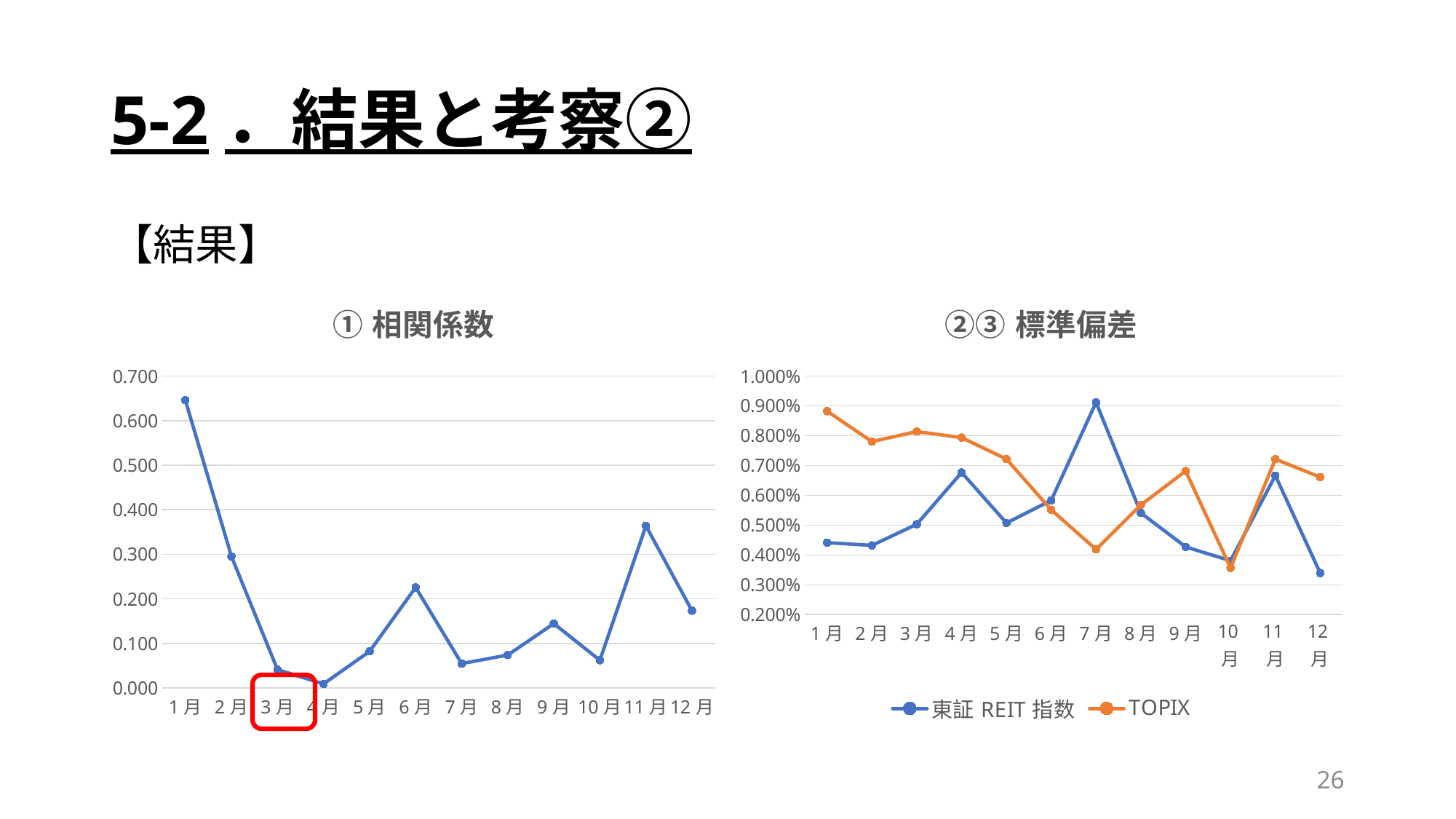
In the ②③ 標準偏差 chart, which month has the lowest value for TOPIX? 10月 In the ① 相関係数 chart, is the value for 11月 greater or less than 0.300? greater In the ① 相関係数 chart, which month has the highest value? 1月 How many series does the legend of the ②③ 標準偏差 chart list? 2 In the ②③ 標準偏差 chart, do the TOPIX values rise or fall from 1月 to 5月? fall In the ① 相関係数 chart, do the values rise or fall from 1月 to 3月? fall In the ① 相関係数 chart, is the value for 1月 greater or less than 0.600? greater In the ① 相関係数 chart, is the value for 7月 greater or less than 0.100? less In the ②③ 標準偏差 chart, which series has the larger value in 1月, 東証 REIT 指数 or TOPIX? TOPIX In the ②③ 標準偏差 chart, which month has the highest value for 東証 REIT 指数? 7月 How many months are plotted on the x axis of the ① 相関係数 chart? 12 What kind of chart is the ① 相関係数 chart on the left? line chart